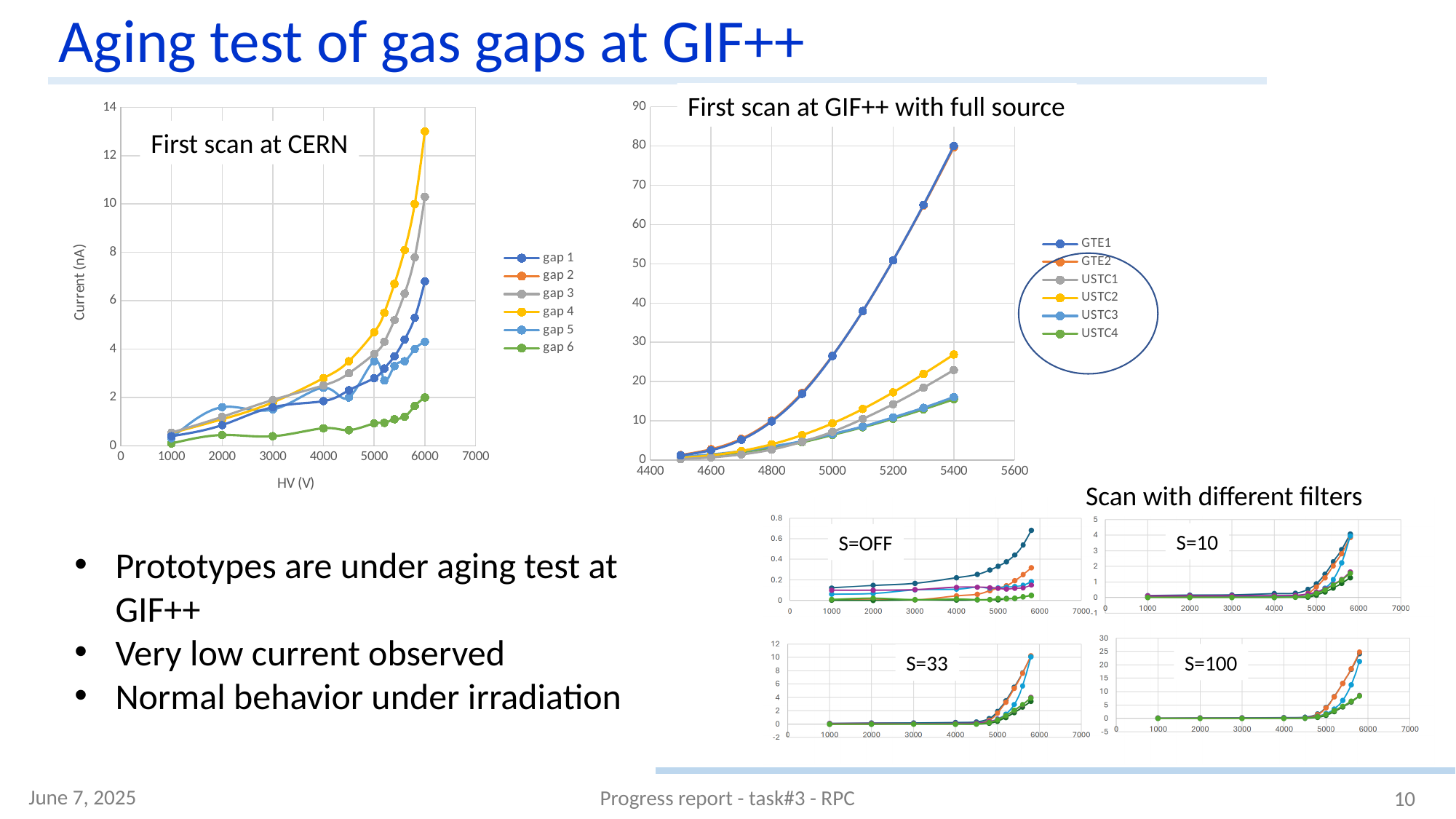
In the "First scan at CERN" chart, which is larger at 6000 V, gap 4 or gap 3? gap 4 In the "First scan at GIF++ with full source" chart, which is larger at 5400, USTC2 or USTC1? USTC2 In the "First scan at GIF++ with full source" chart, how many series does the legend list? 6 In the "First scan at CERN" chart, is the current for gap 4 at 6000 V greater or less than 12? greater In the "First scan at CERN" chart, is the current for gap 6 at 6000 V greater or less than 4? less In the "First scan at CERN" chart, which gap has the highest current at 6000 V? gap 4 What kind of chart is the "First scan at CERN" chart? line chart In the "First scan at GIF++ with full source" chart, does the GTE1 series rise or fall as the x-axis value increases? rise What is the x-axis label of the "First scan at CERN" chart? HV (V) In the "First scan at GIF++ with full source" chart, is the value for GTE1 at 5400 greater or less than 70? greater In the "First scan at CERN" chart, which gap has the lowest current at 6000 V? gap 6 In the "First scan at CERN" chart, how many series does the legend list? 6